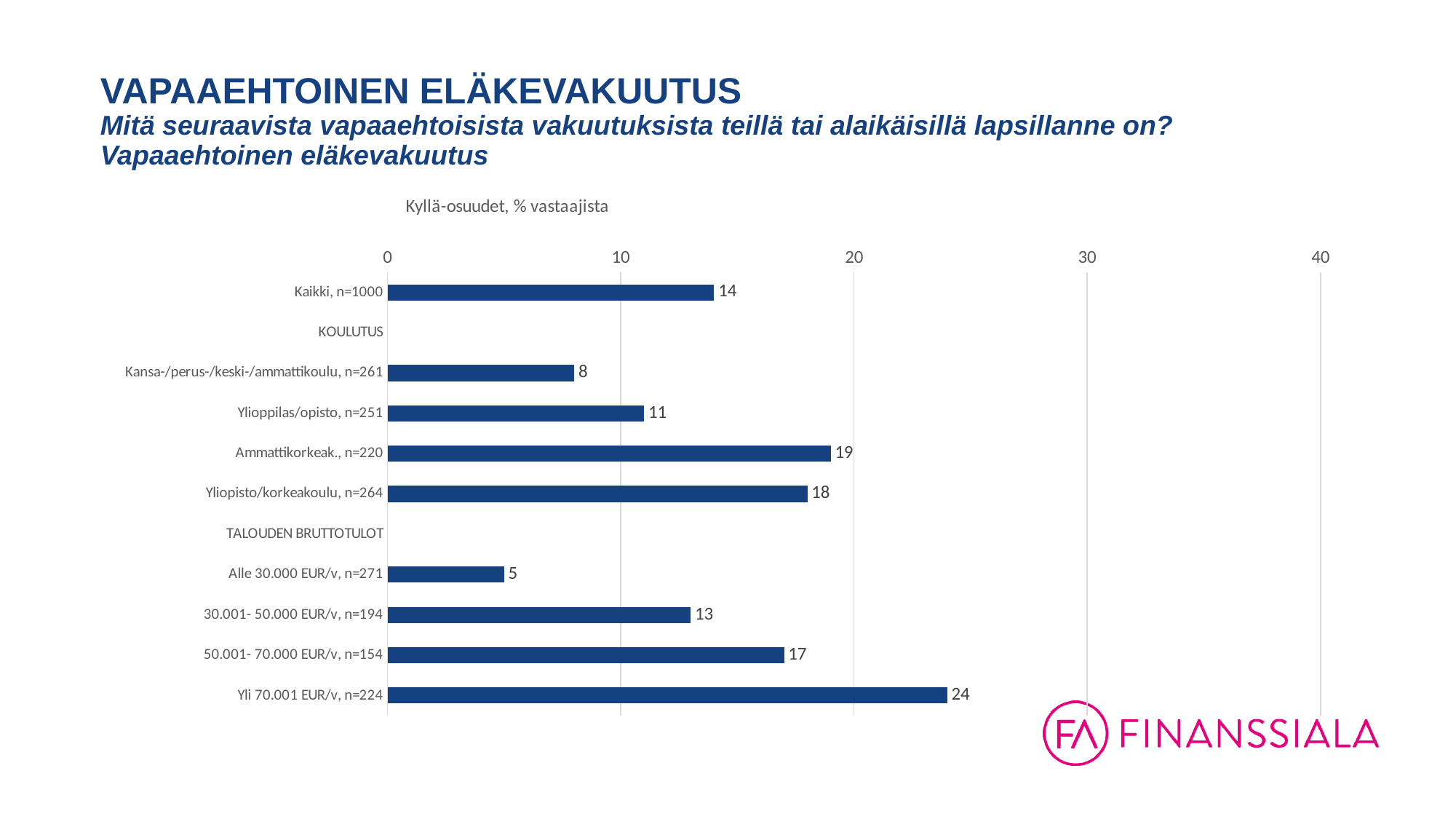
What is the value for Ammattikorkeak., n=220? 19 Which category has the lowest value? Alle 30.000 EUR/v, n=271 Is the value for Ylioppilas/opisto, n=251 greater or less than 10? greater What kind of chart is shown on the slide? Bar chart What is the value for Kaikki, n=1000? 14 Which category has the highest value? Yli 70.001 EUR/v, n=224 What is the difference between the values for Yliopisto/korkeakoulu, n=264 and Kansa-/perus-/keski-/ammattikoulu, n=261? 10 What is the highest value shown on the horizontal axis? 40 What is the chart's subtitle describing the plotted values? Kyllä-osuudet, % vastaajista How many bars are plotted in the chart? 9 What is the value for Yli 70.001 EUR/v, n=224? 24 Which is larger, the value for 50.001- 70.000 EUR/v, n=154 or the value for 30.001- 50.000 EUR/v, n=194? 50.001- 70.000 EUR/v, n=154